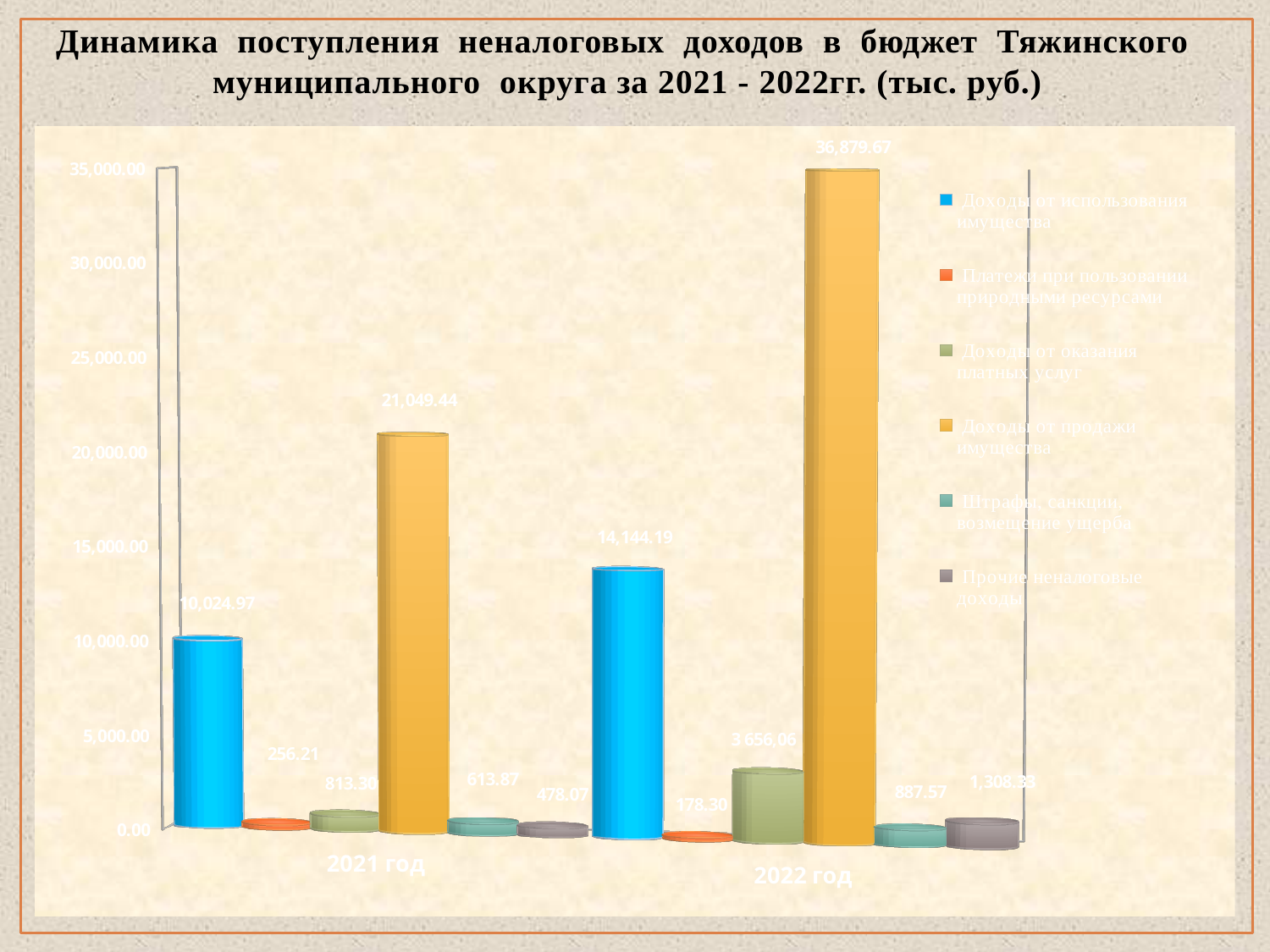
What is the difference between Доходы от использования имущества in 2022 год and 2021 год? 4,119.22 How many year categories are shown on the x axis? 2 Which series has the highest value in 2022 год? Доходы от продажи имущества What is the value of Доходы от продажи имущества for 2022 год? 36,879.67 Which is larger: Доходы от продажи имущества in 2021 год or in 2022 год? 2022 год What is the value of Доходы от использования имущества for 2021 год? 10,024.97 How many series does the legend list? 6 What is the value of Штрафы, санкции, возмещение ущерба for 2021 год? 613.87 What is the value of Платежи при пользовании природными ресурсами for 2022 год? 178.30 Does the value of Доходы от использования имущества for 2022 год rise or fall compared with 2021 год? rise What type of chart is shown on the slide? bar chart Which series has the lowest value in 2021 год? Платежи при пользовании природными ресурсами